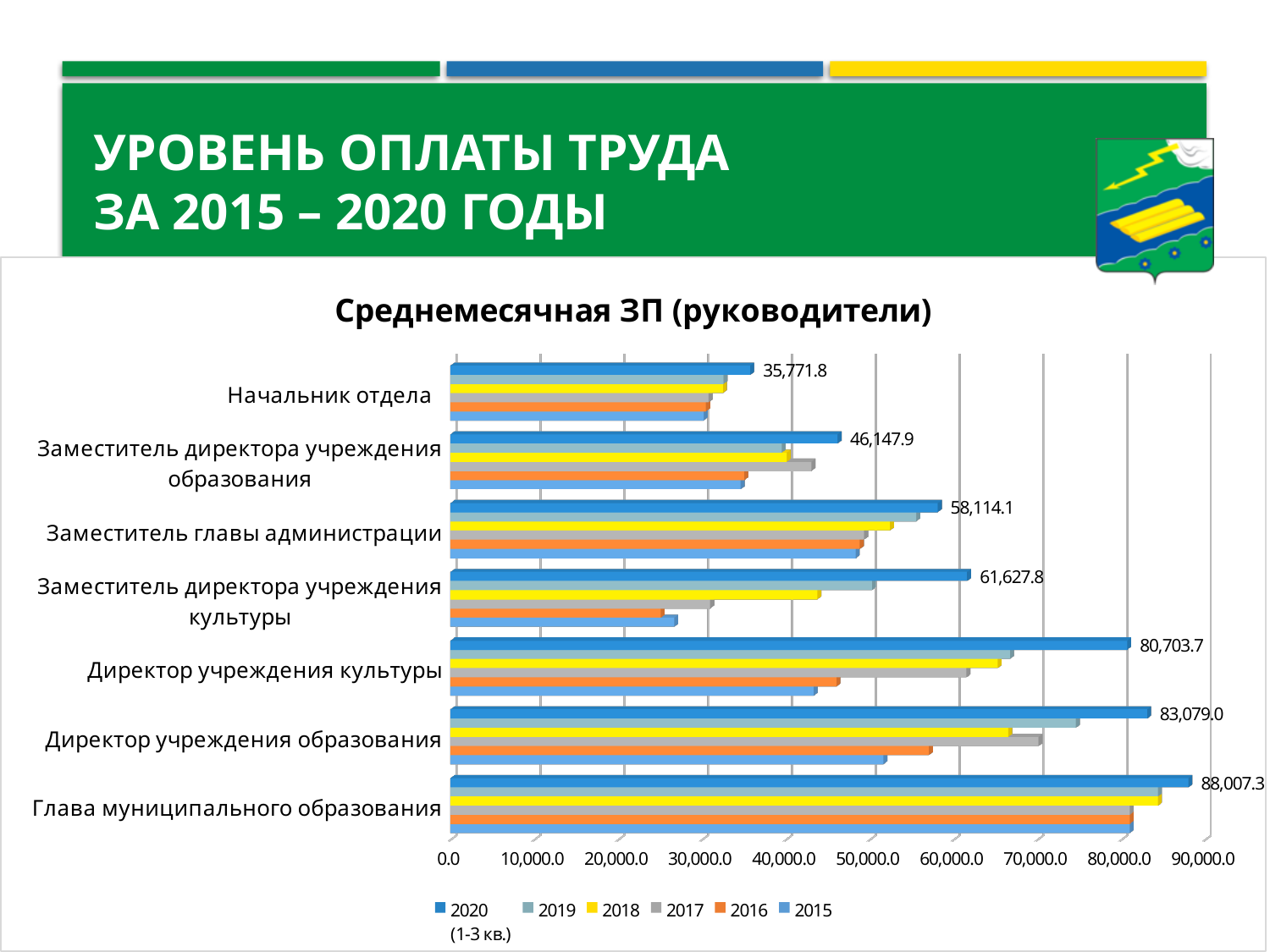
How many job categories are shown on the chart? 7 How many series does the legend list? 6 What is the 2020 (1-3 кв.) value for Заместитель главы администрации? 58,114.1 What is the difference between the 2020 (1-3 кв.) values for Глава муниципального образования and Директор учреждения образования? 4,928.3 Is the 2016 value for Заместитель директора учреждения культуры greater or less than 30,000.0? less Which has the larger 2020 (1-3 кв.) value: Директор учреждения культуры or Директор учреждения образования? Директор учреждения образования Which category has the highest 2020 (1-3 кв.) value? Глава муниципального образования What is the 2020 (1-3 кв.) value for Глава муниципального образования? 88,007.3 Which category has the lowest 2020 (1-3 кв.) value? Начальник отдела What is the 2020 (1-3 кв.) value for Начальник отдела? 35,771.8 What type of chart is shown on the slide? Bar chart Is the 2015 value for Директор учреждения культуры greater or less than 50,000.0? less